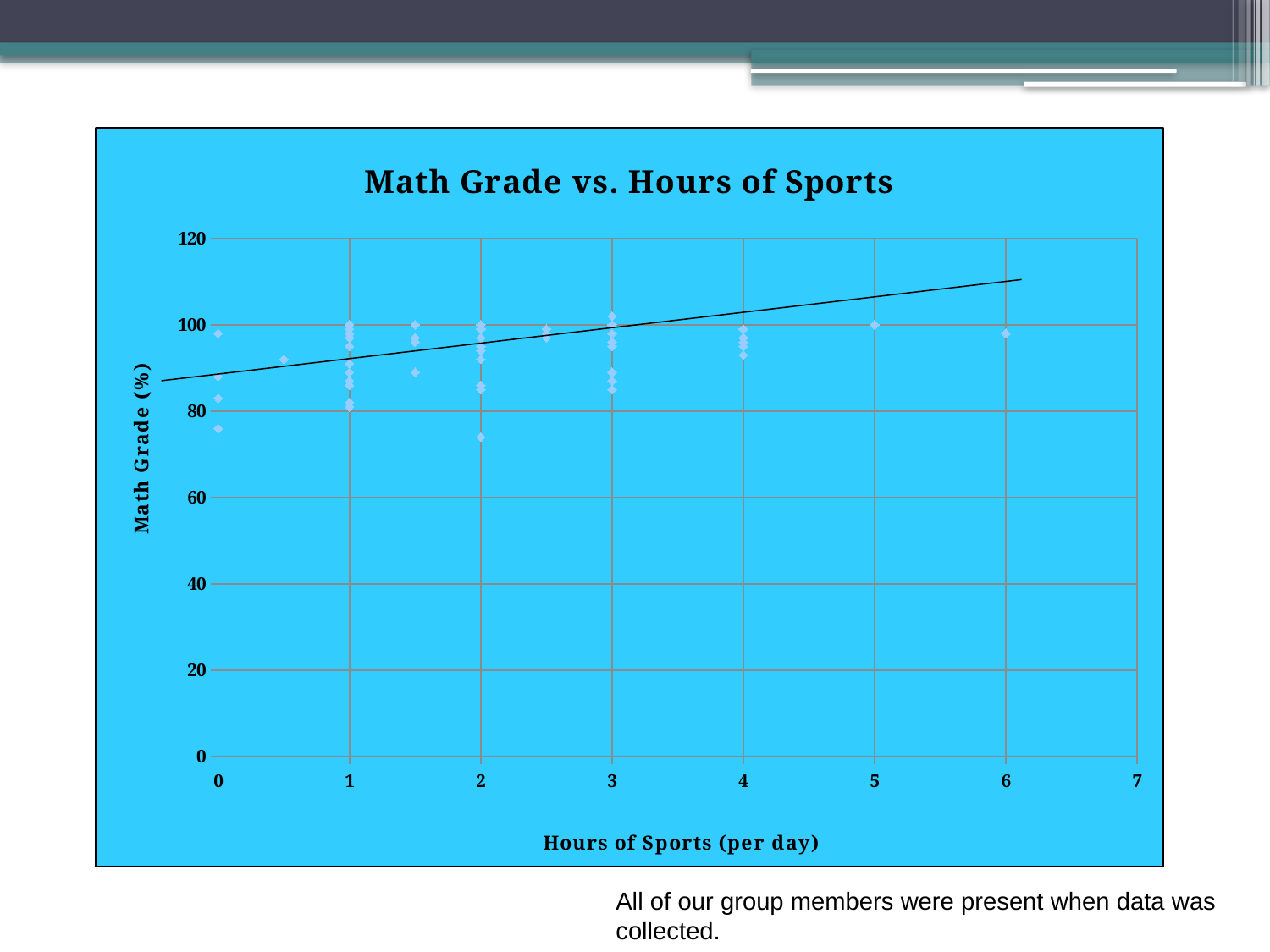
Is the lowest point at 3 hours of sports greater or less than 80? greater Is the lowest point at 2 hours of sports greater or less than 80? less Is the point at 0.5 hours of sports greater or less than 80? greater What is the label of the y axis? Math Grade (%) What is the highest value shown on the y axis? 120 Does the trend line rise or fall as Hours of Sports increases? rises What kind of chart is shown on the slide? scatter chart What is the title of the chart? Math Grade vs. Hours of Sports